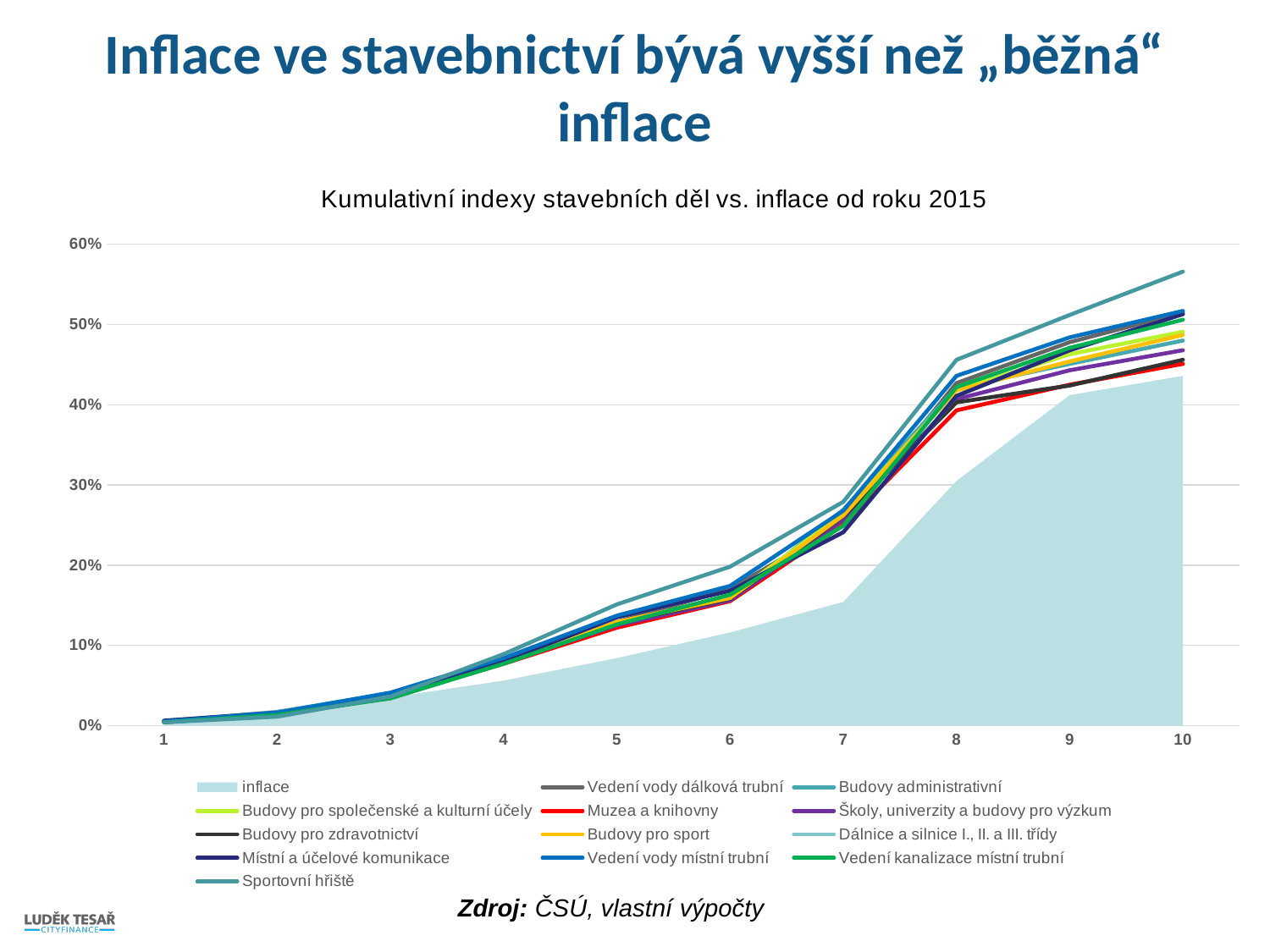
What kind of chart is shown on the slide? combination area and line chart Is the value for inflace at point 10 greater or less than 50%? less Is the value for inflace at point 7 greater or less than 20%? less Is the highest line in the chart at point 10 greater or less than 50%? greater Which series has the lowest value at point 10? inflace Do the values in the chart rise or fall along the x axis? rise What is the title of the chart? Kumulativní indexy stavebních děl vs. inflace od roku 2015 How many points are there along the x axis of the chart? 10 How many series does the chart legend list? 13 Which series is shown as a shaded area rather than a line? inflace